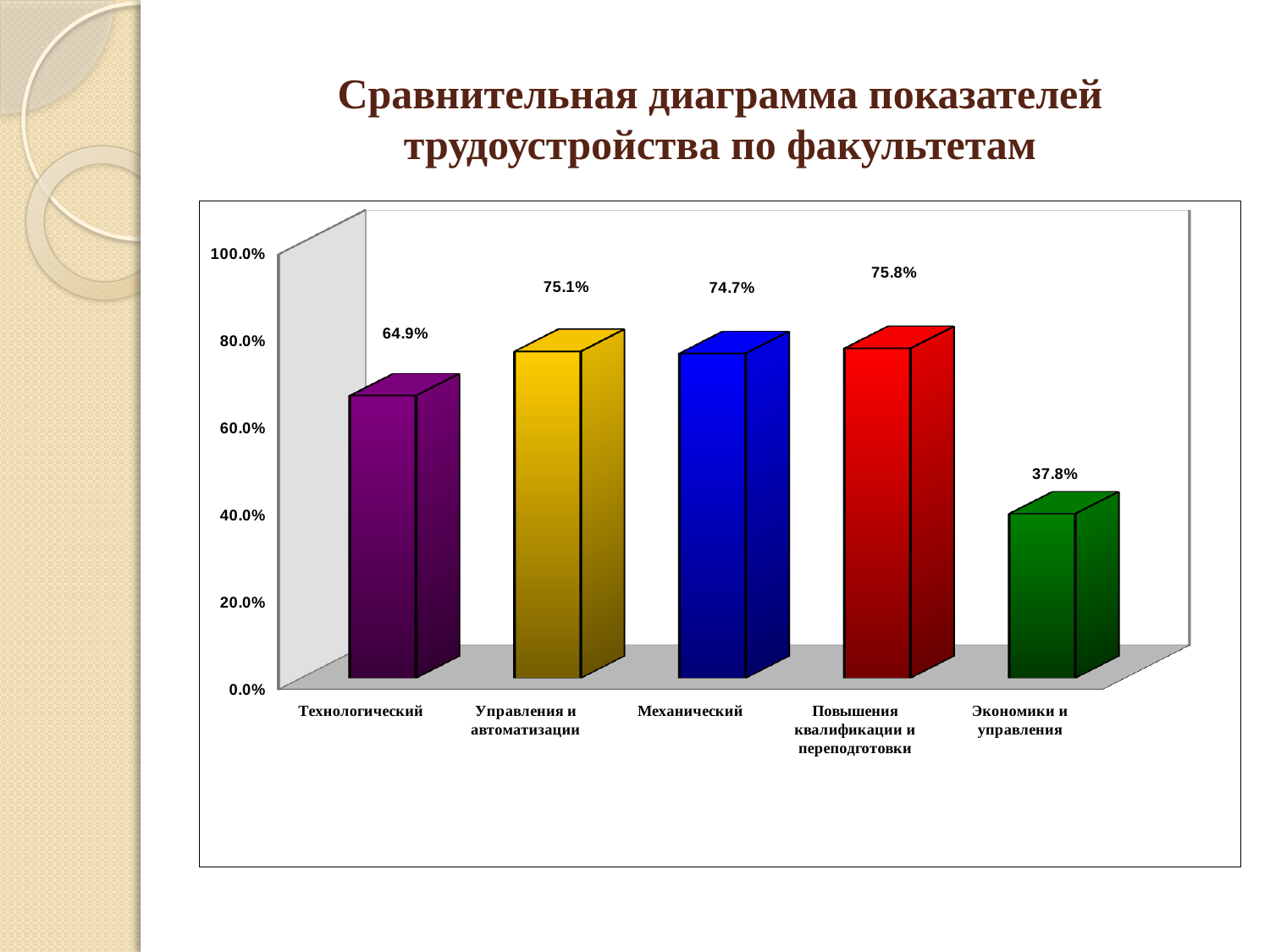
What kind of chart is shown on the slide? Bar chart How many faculties are shown on the chart? 5 What is the employment rate for the Технологический faculty? 64.9% What value is shown for Экономики и управления? 37.8% What is the value for the Механический faculty? 74.7% Which is larger: the value for Технологический or the value for Экономики и управления? Технологический Which faculty has the highest employment rate? Повышения квалификации и переподготовки What is the difference between the values for Управления и автоматизации and Технологический? 10.2% Which faculty has the lowest employment rate? Экономики и управления What is the difference between the values for Повышения квалификации и переподготовки and Экономики и управления? 38.0% What is the value for Повышения квалификации и переподготовки? 75.8% What colour is the bar for the Механический faculty? Blue